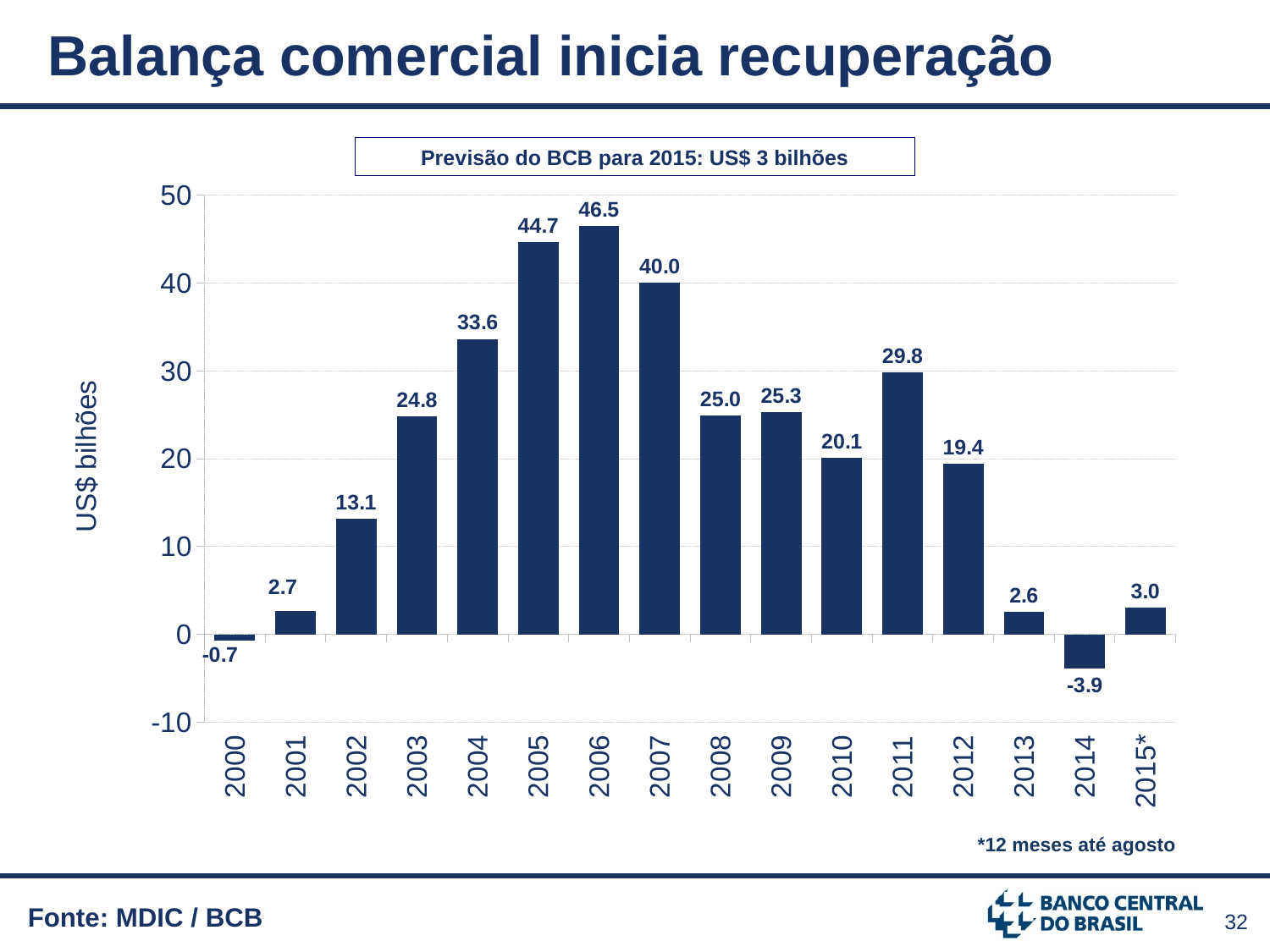
What is the value for 2014? -3.9 How many years are shown on the x axis? 16 What is the value for 2006? 46.5 Which year has the highest value? 2006 What is the y-axis label? US$ bilhões Which year has the lowest value? 2014 What is the value for 2002? 13.1 What kind of chart is this? bar chart Do the values rise or fall from 2011 to 2014? fall What is the difference between the values for 2005 and 2007? 4.7 What is the BCB forecast for 2015 stated in the box above the chart? US$ 3 bilhões Which is larger, the value for 2008 or the value for 2009? 2009